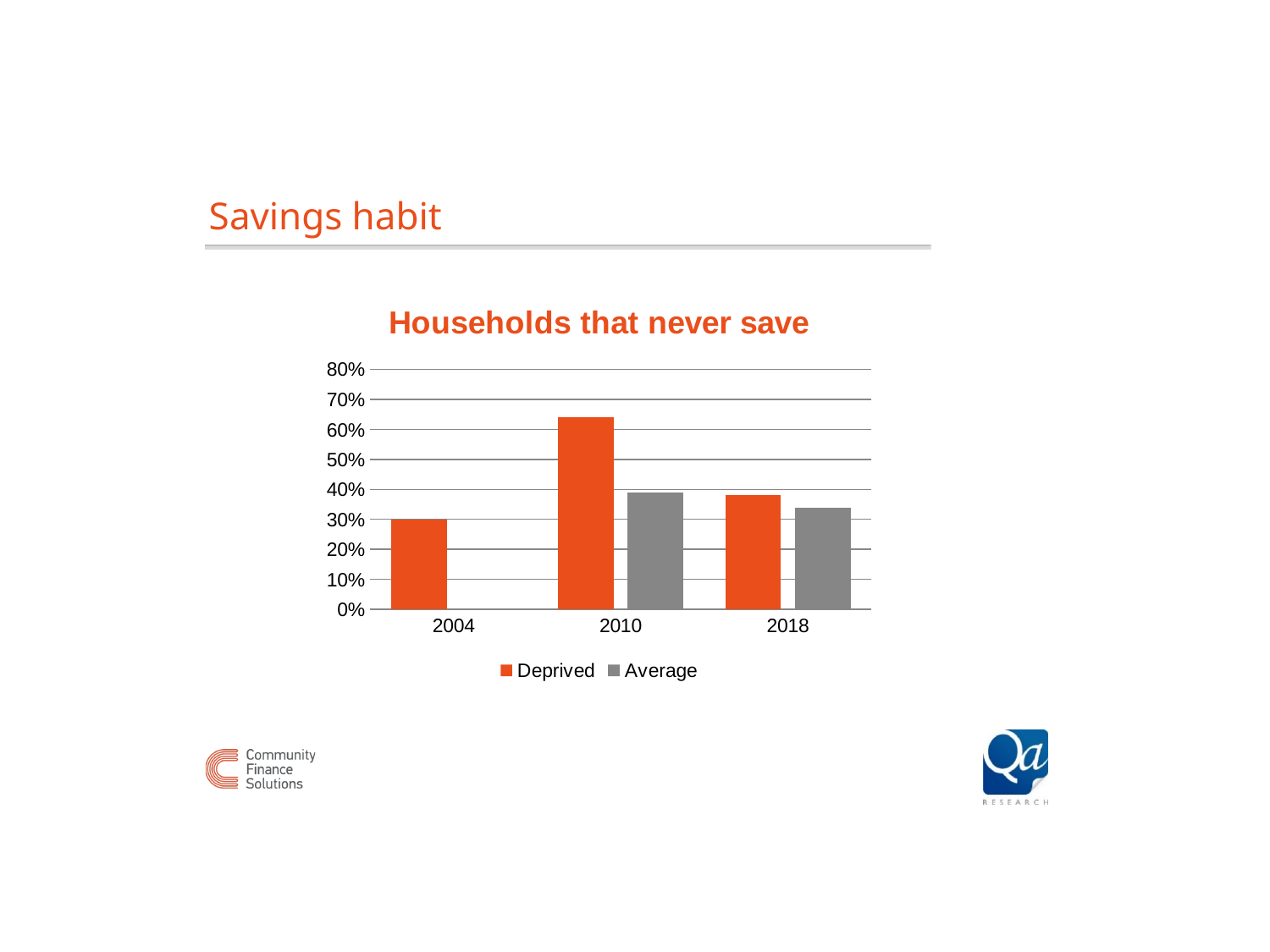
How many series does the legend list? 2 In which year is the Deprived value highest? 2010 Which colour represents the Deprived series? orange Does the Deprived value rise or fall from 2010 to 2018? fall Is the Deprived value for 2010 greater or less than 60%? greater Is the Average value for 2018 greater or less than 30%? greater How many years are shown on the x axis? 3 Is the Deprived value for 2018 greater or less than 40%? less What type of chart is shown on the slide? bar chart What is the title of the chart? Households that never save In which year is the Deprived value lowest? 2004 In 2010, which is larger, the Deprived value or the Average value? Deprived